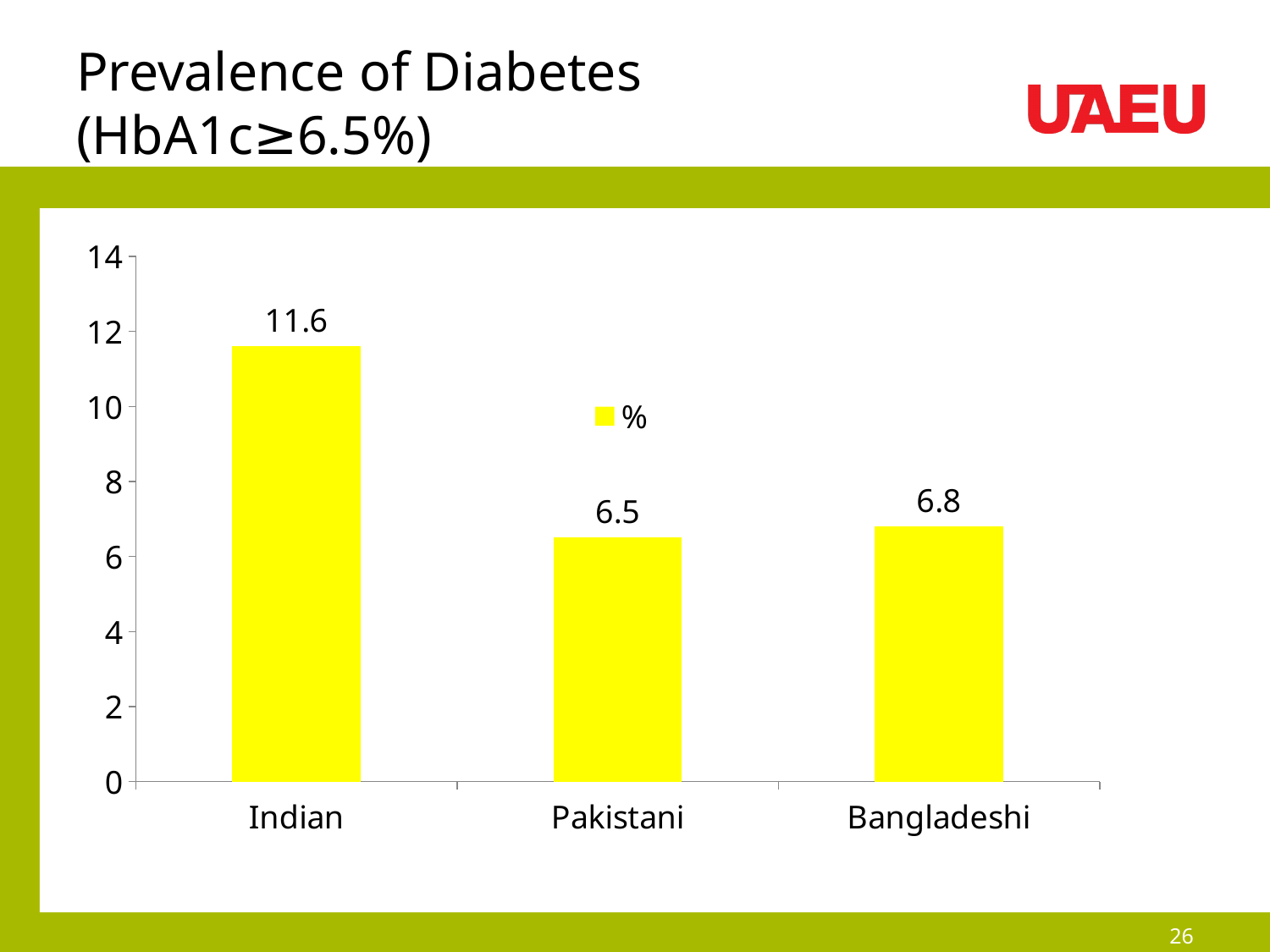
What is the value for Indian? 11.6 Which category has the highest value? Indian What is the difference between the values for Bangladeshi and Pakistani? 0.3 What is the legend entry shown on the chart? % Which category has the lowest value? Pakistani What is the value for Bangladeshi? 6.8 What is the difference between the values for Indian and Pakistani? 5.1 How many categories are shown on the x axis? 3 Which is larger, the value for Indian or the value for Bangladeshi? Indian What is the value for Pakistani? 6.5 Is the value for Indian greater or less than 10? greater What kind of chart is shown on the slide? bar chart